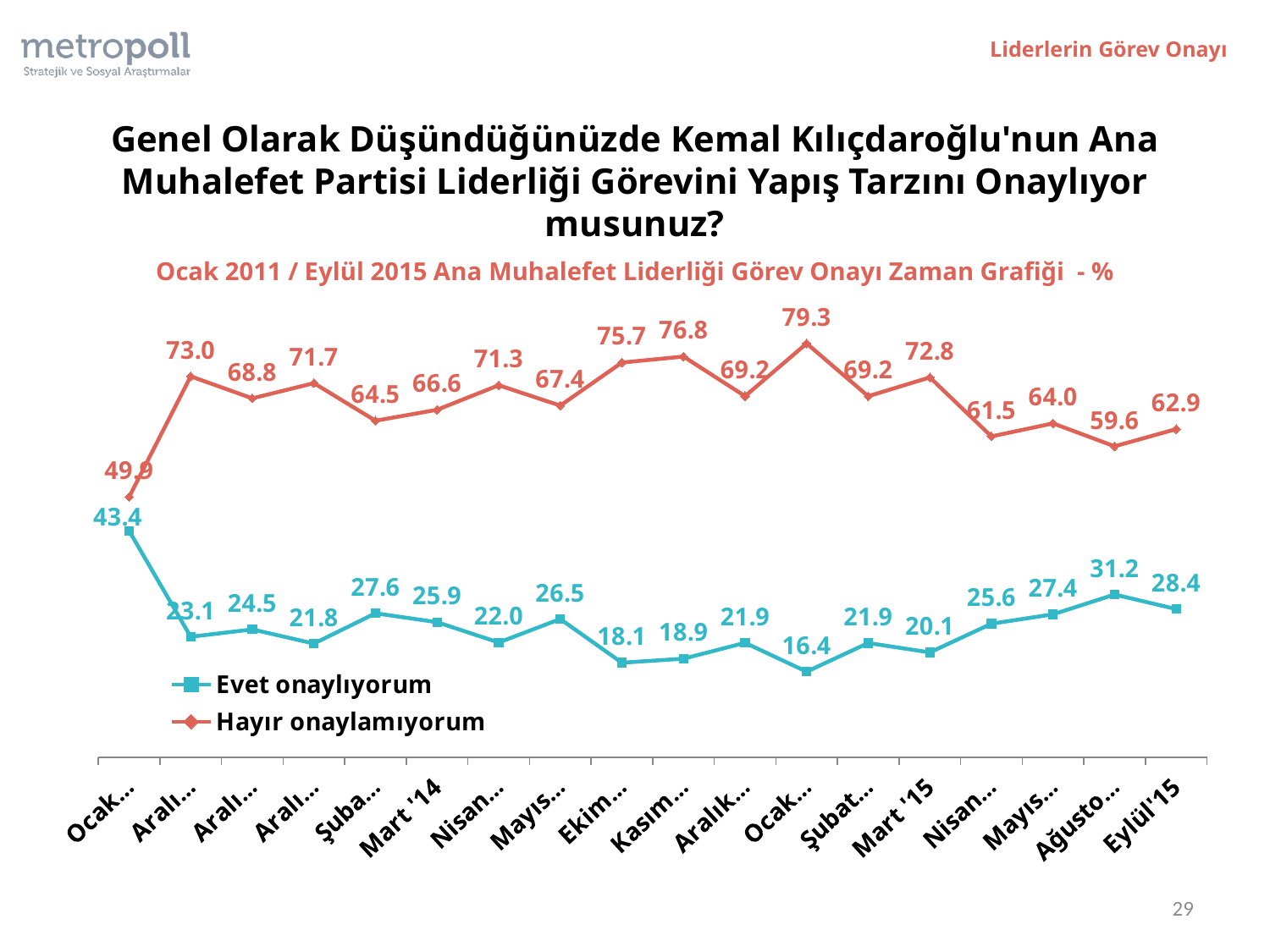
What kind of chart is shown on the slide? Line chart How many data points does each series have? 18 What is the highest value reached by the "Hayır onaylamıyorum" series? 79.3 What is the value for "Hayır onaylamıyorum" at Eylül'15? 62.9 What is the value for "Hayır onaylamıyorum" at Mart '14? 66.6 At Eylül'15, what is the difference between "Hayır onaylamıyorum" and "Evet onaylıyorum"? 34.5 For "Hayır onaylamıyorum", which is larger: the value at Mart '14 or at Mart '15? Mart '15 Which series is drawn in red? Hayır onaylamıyorum How many series does the legend list? 2 What is the value for "Evet onaylıyorum" at Mart '15? 20.1 What is the value for "Evet onaylıyorum" at Eylül'15? 28.4 What is the lowest value reached by the "Evet onaylıyorum" series? 16.4